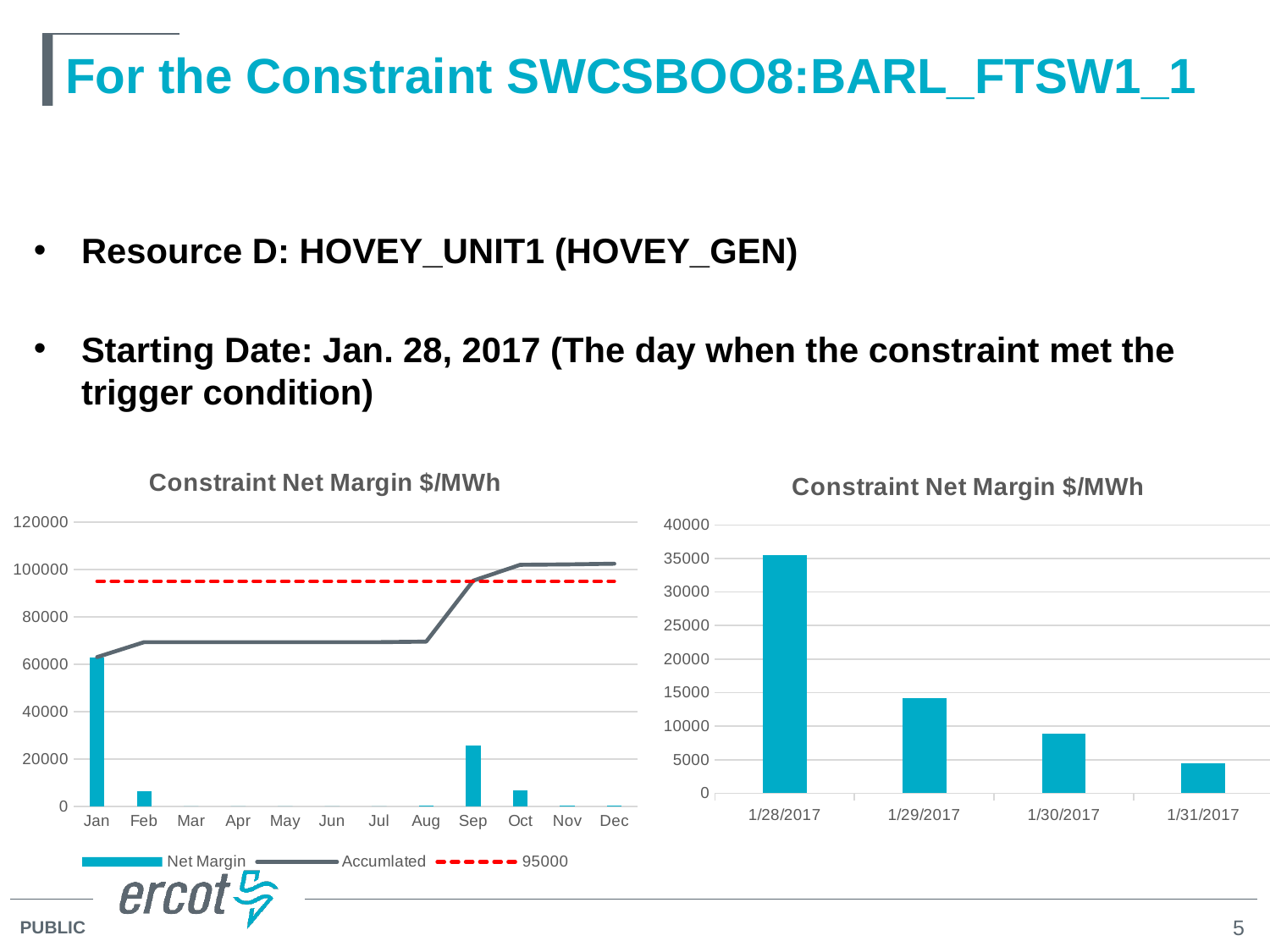
In the left chart, is the Net Margin value for Sep greater or less than 20000? greater In the left chart, how many series does the legend list? 3 In the left chart, does the Accumulated line rise or fall from Jan to Dec? rise In the left chart, which is larger: the Net Margin for Sep or for Feb? Sep In the left chart, which month has the highest Net Margin bar? Jan In the right chart, which date has the lowest bar? 1/31/2017 What kind of chart is the right chart? bar chart In the left chart, what value does the red dashed line represent according to the legend? 95000 In the left chart, is the Net Margin value for Jan greater or less than 60000? greater In the right chart, which date has the highest bar? 1/28/2017 In the right chart, how many dates are shown on the x axis? 4 In the left chart, is the Accumulated value in Dec greater or less than 100000? greater